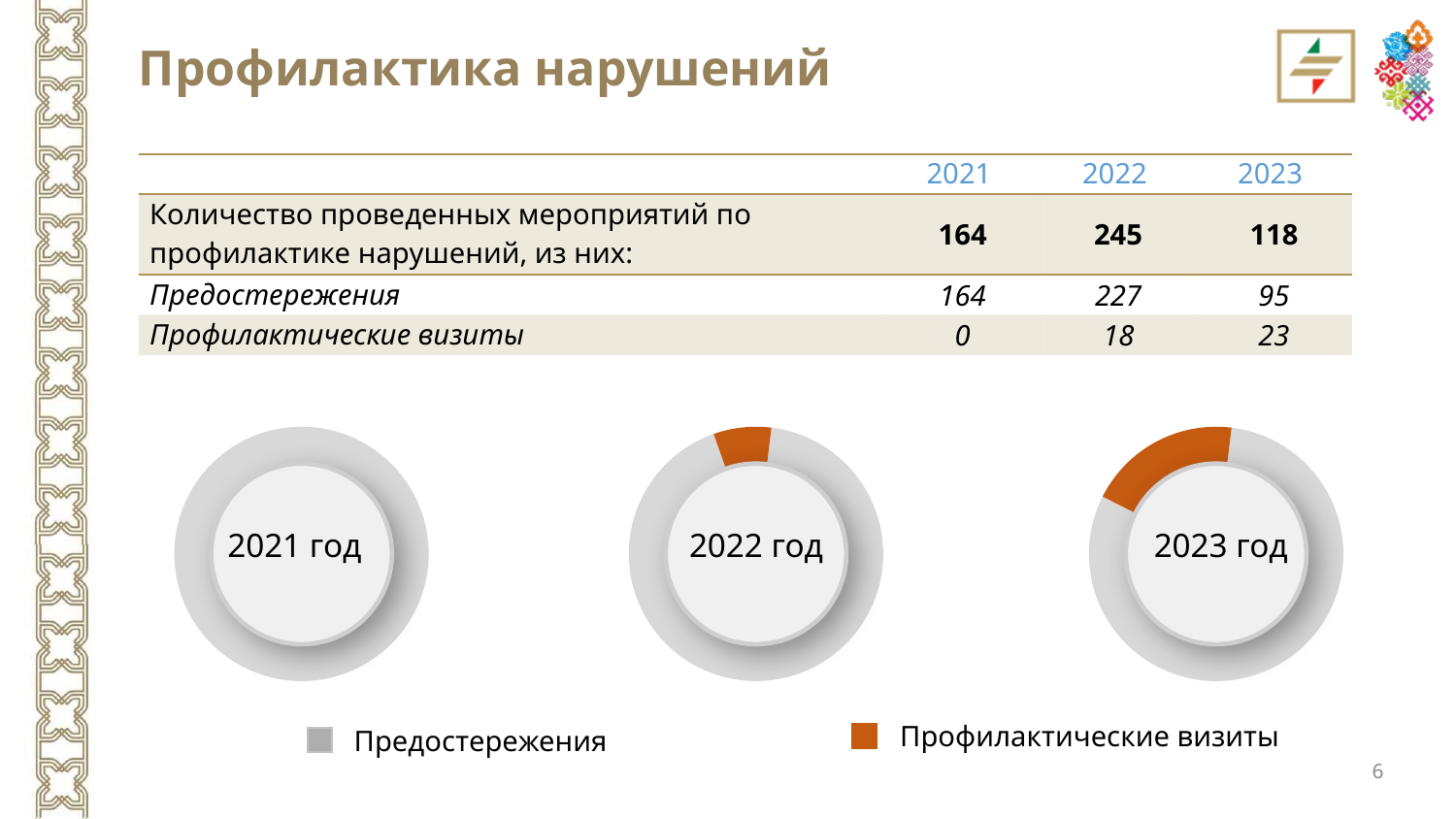
In the 2022 год doughnut chart, which series is larger: Предостережения or Профилактические визиты? Предостережения Does the number of Профилактические визиты rise or fall from 2021 to 2023? Rise By how much did the number of Предостережения in 2022 exceed that in 2023? 132 According to the table, how many Профилактические визиты were held in 2023? 23 What kind of chart is used for the three year diagrams on the slide? Doughnut chart Which colour represents Профилактические визиты in the doughnut charts? Orange How many series does the legend below the doughnut charts list? 2 How many doughnut charts are shown on the slide? 3 Which year's doughnut chart has no Профилактические визиты segment at all? 2021 год According to the table, what is the total number of preventive measures (Количество проведенных мероприятий) in 2021? 164 Which year's doughnut chart has the largest share of Профилактические визиты? 2023 год According to the table, how many Предостережения were issued in 2022? 227